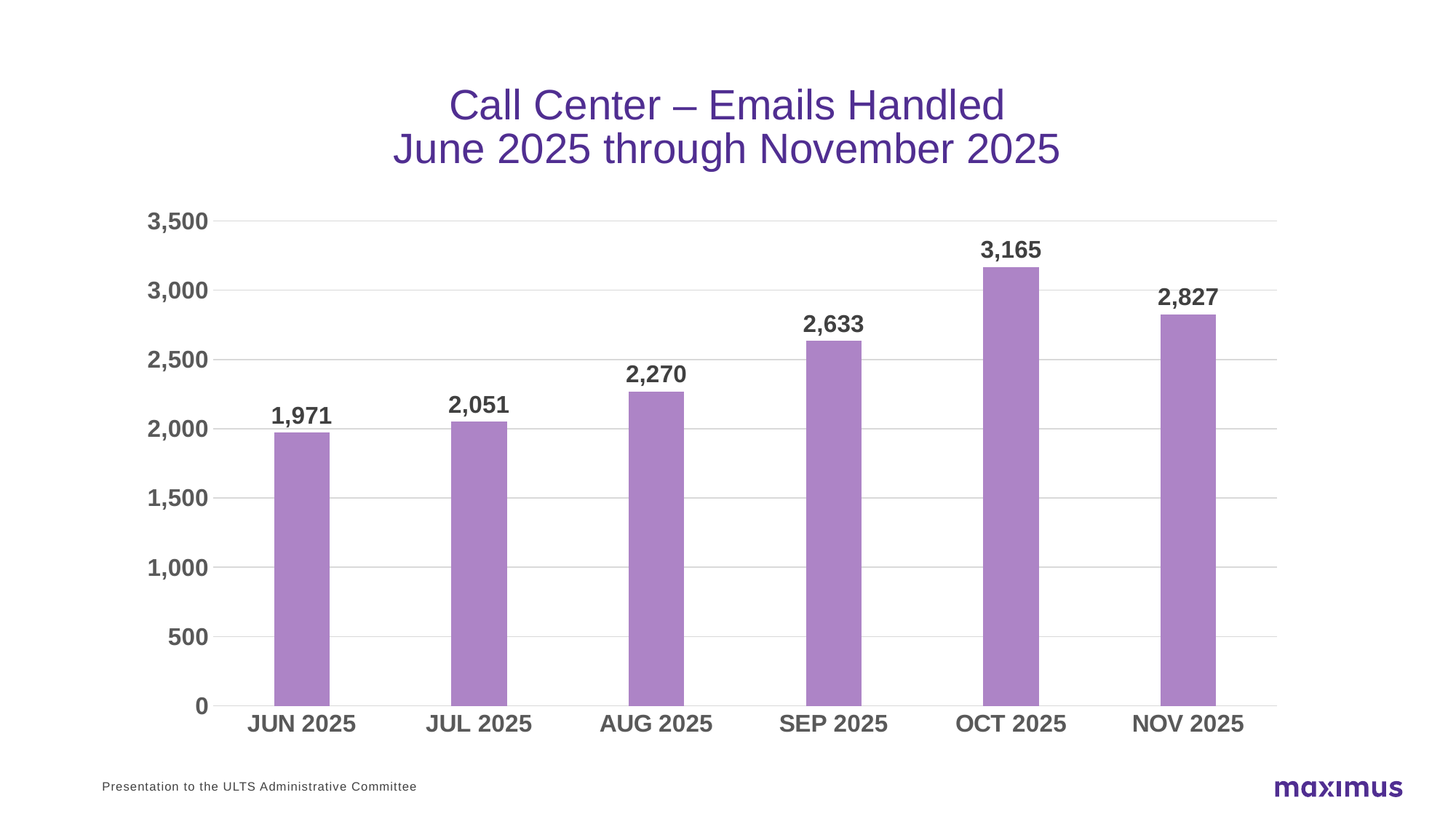
Is the value for NOV 2025 greater or less than 3,000? less Do the values rise or fall from JUN 2025 to OCT 2025? rise What kind of chart is shown on the slide? bar chart What is the value for JUN 2025? 1,971 What is the difference between the values for AUG 2025 and JUL 2025? 219 Which month has the lowest number of emails handled? JUN 2025 How many months are shown on the chart? 6 How many emails were handled in SEP 2025? 2,633 What is the title of the chart? Call Center – Emails Handled June 2025 through November 2025 Which is larger, the value for SEP 2025 or the value for AUG 2025? SEP 2025 Which month has the highest number of emails handled? OCT 2025 What is the difference between the values for OCT 2025 and NOV 2025? 338